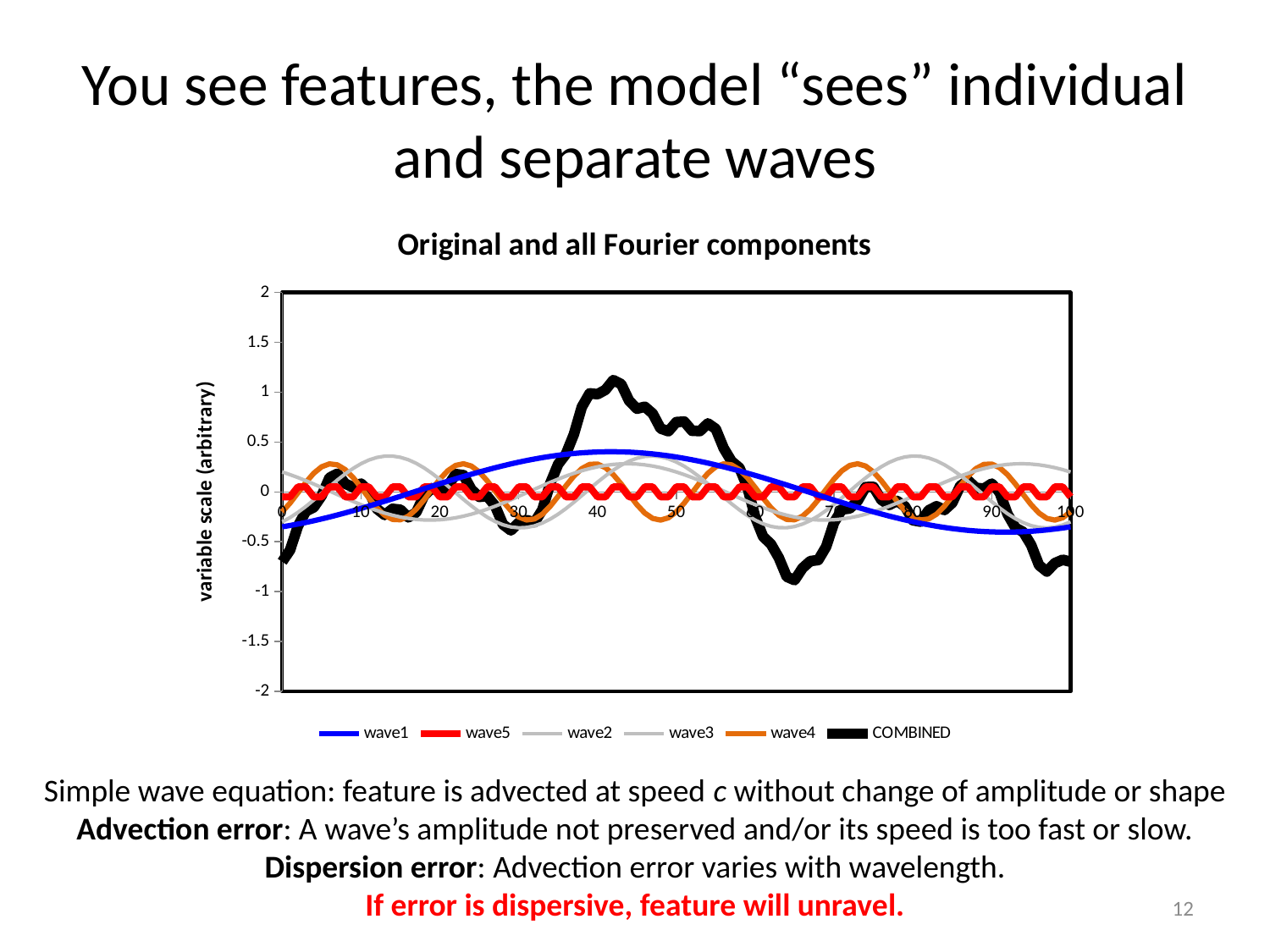
Is the maximum value of wave1 greater or less than 0.5? less Is the value of COMBINED at x=0 greater or less than -0.5? less What is the title of the chart? Original and all Fourier components Is the value of COMBINED at x=40 greater or less than 0.5? greater How many series does the legend list? 6 Which reaches a higher peak, COMBINED or wave1? COMBINED What kind of chart is shown on the slide? line chart Does wave1 rise or fall between x=0 and x=40? rise Which series reaches the lowest value on the chart? COMBINED What is the label on the y axis of the chart? variable scale (arbitrary) Which series has the smallest amplitude on the chart? wave5 Which series reaches the highest value on the chart? COMBINED